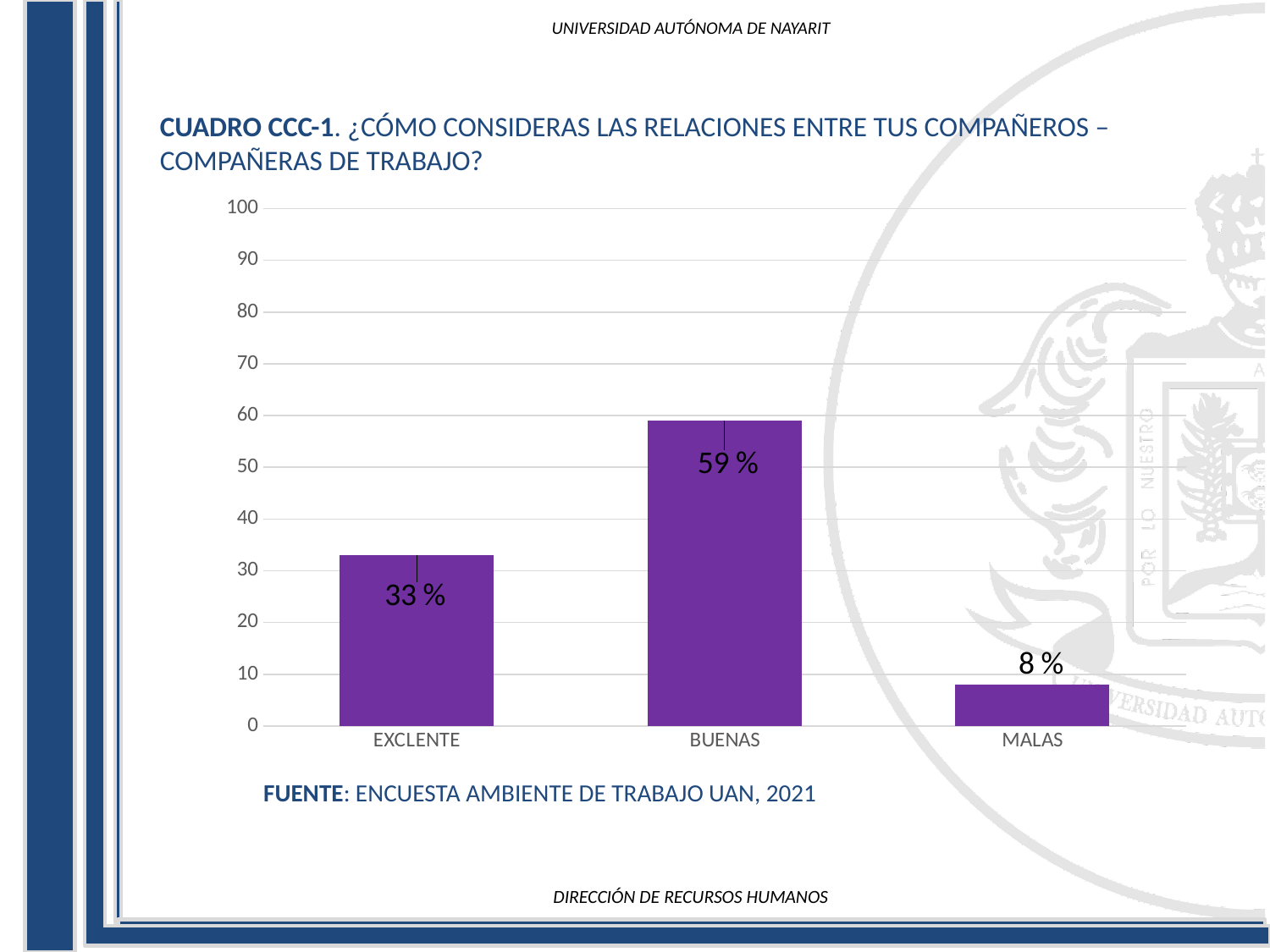
What is the value for EXCLENTE? 33 % What is the value for BUENAS? 59 % Which is larger, the value for EXCLENTE or the value for MALAS? EXCLENTE What kind of chart is shown on the slide? bar chart How many categories are shown on the x axis? 3 What is the value for MALAS? 8 % Which category has the lowest value? MALAS What is the difference between the values for BUENAS and EXCLENTE? 26 % What is the difference between the values for EXCLENTE and MALAS? 25 % What source is cited below the chart? ENCUESTA AMBIENTE DE TRABAJO UAN, 2021 Is the value for BUENAS greater or less than 50? greater Which category has the highest value? BUENAS